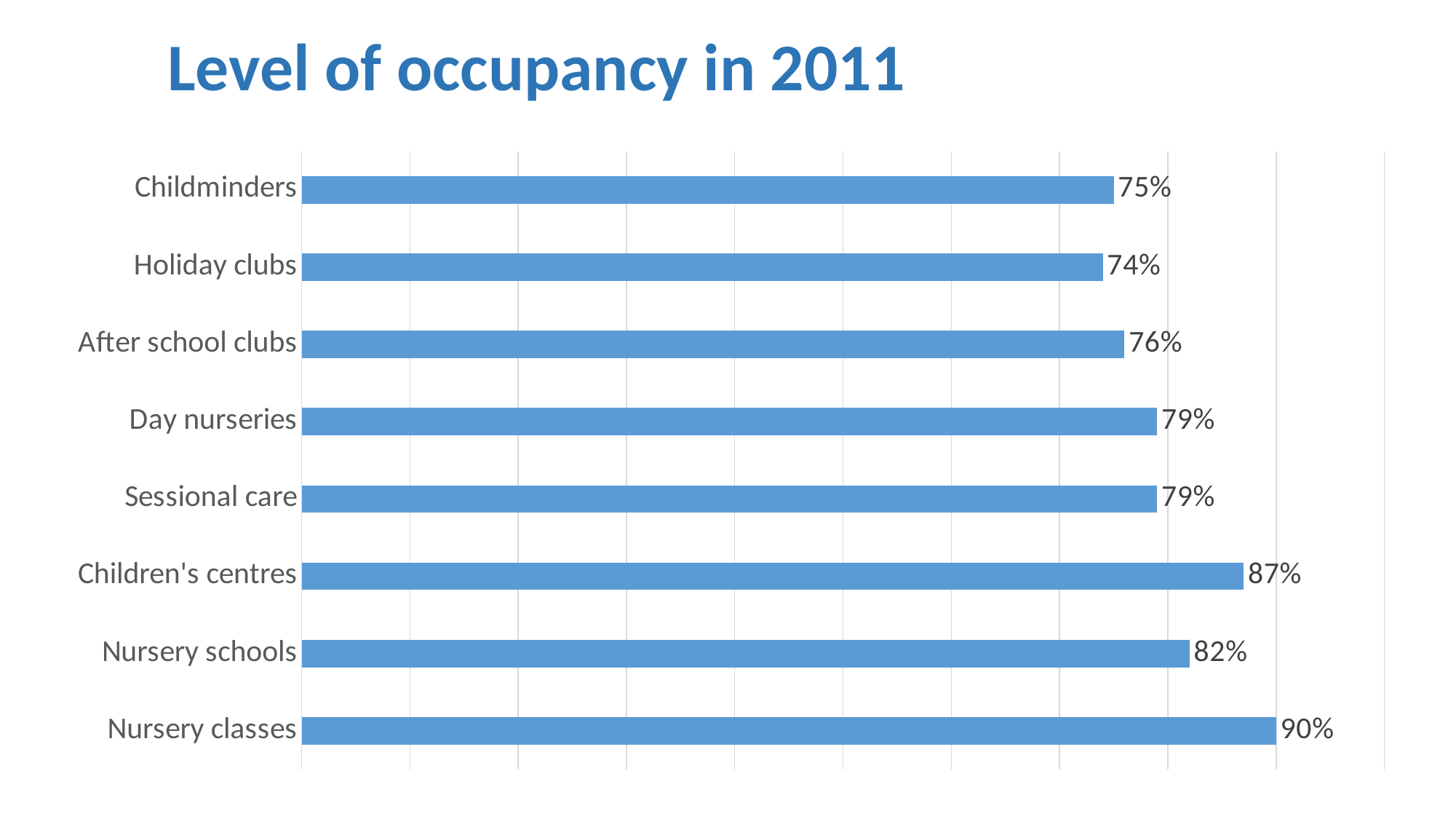
What is the difference in occupancy between Nursery classes and Childminders? 15% What is the difference in occupancy between Children's centres and Nursery schools? 5% What is the level of occupancy for Nursery schools? 82% Which category has the lowest level of occupancy? Holiday clubs What is the title of the chart? Level of occupancy in 2011 Which has a higher level of occupancy, Day nurseries or After school clubs? Day nurseries How many categories are shown in the chart? 8 What is the level of occupancy for Holiday clubs? 74% What is the level of occupancy for Children's centres? 87% Which category has the highest level of occupancy? Nursery classes What is the level of occupancy for Childminders? 75% What kind of chart is shown on the slide? Bar chart